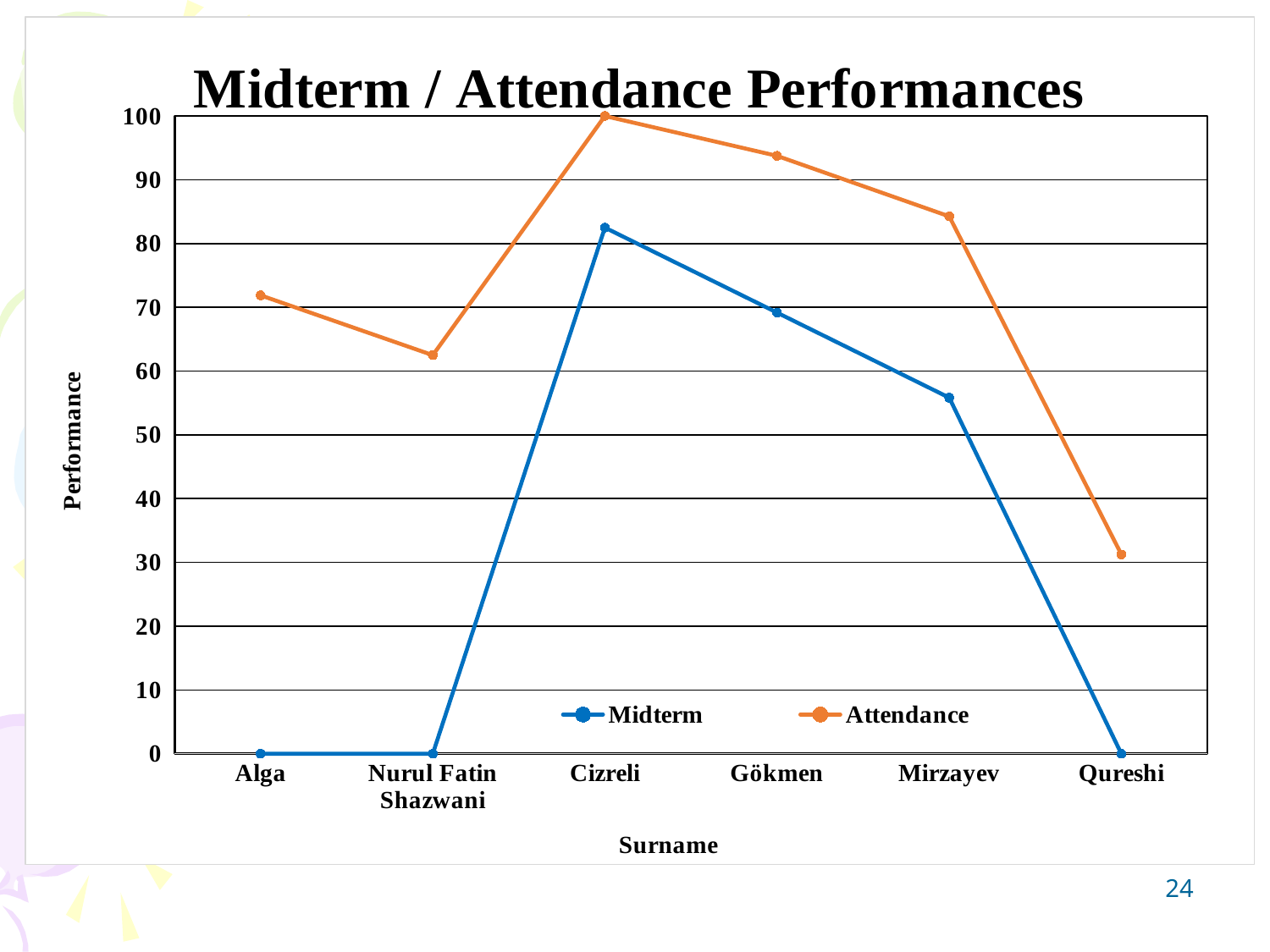
Is the Attendance value for Alga greater or less than 70? greater How many series does the legend list? 2 Which surname has the lowest Attendance value? Qureshi Which surname has the highest Midterm value? Cizreli What kind of chart is shown on the slide? line chart Which is larger, the Attendance value for Gökmen or for Mirzayev? Gökmen What is the Attendance value for Cizreli? 100 Do the Attendance values rise or fall from Cizreli to Qureshi? fall Is the Midterm value for Mirzayev greater or less than 60? less Which surname has the highest Attendance value? Cizreli What is the Midterm value for Alga? 0 How many surnames are shown on the x axis? 6